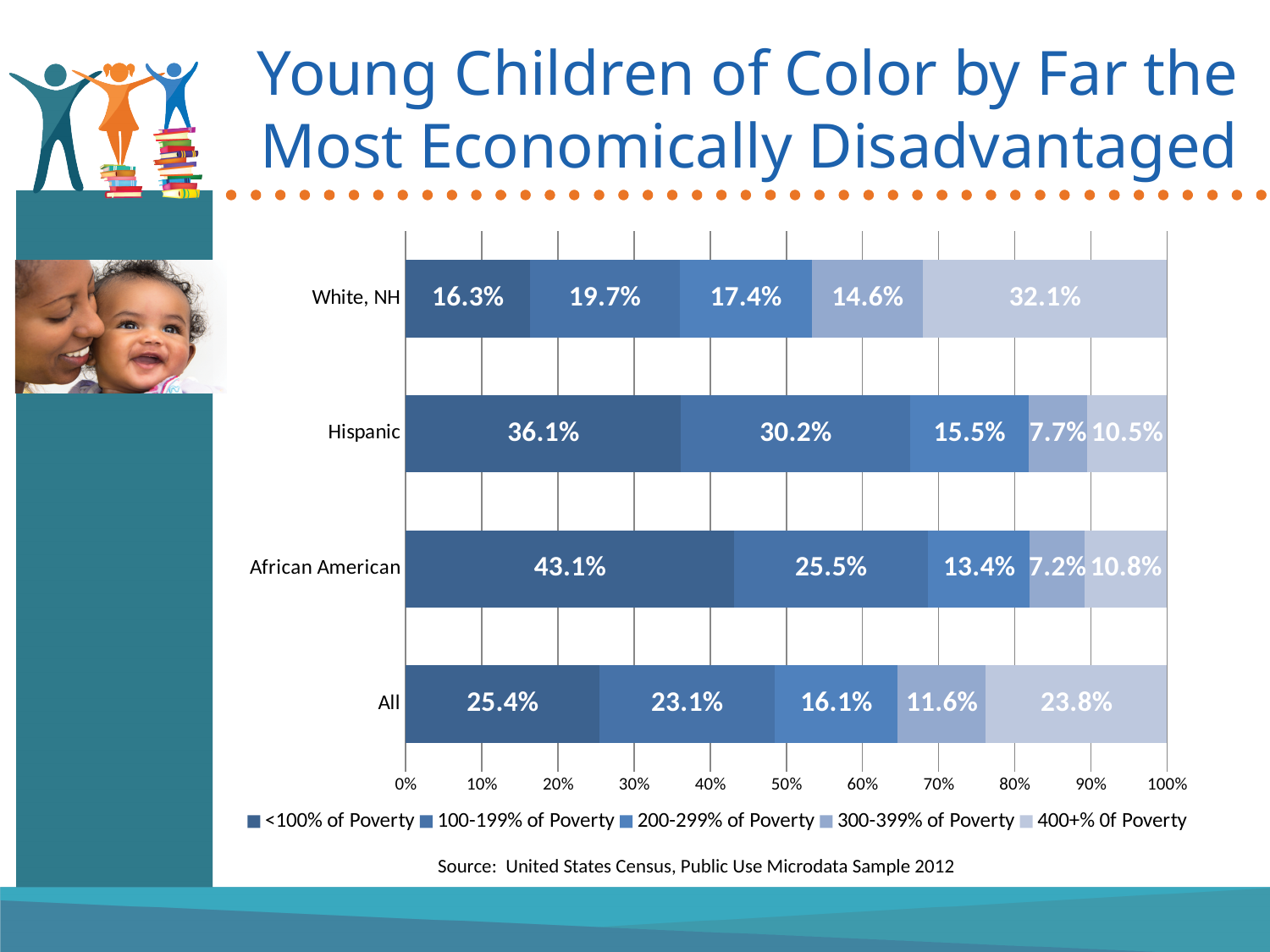
What percentage of White, NH young children are below 100% of poverty? 16.3% What kind of chart is shown on the slide? Stacked bar chart Which is larger: the 200-299% of Poverty value for Hispanic or for All? All How many series does the legend list? 5 How many categories (bars) are shown on the chart? 4 What is the 300-399% of Poverty value for the 'All' category? 11.6% Which category has the highest value in the 400+% of Poverty series? White, NH How many percentage points higher is the <100% of Poverty value for African American children than for White, NH children? 26.8 percentage points Which category has the highest value in the <100% of Poverty series? African American Which category has the lowest value in the <100% of Poverty series? White, NH What is the value for Hispanic children in the 100-199% of Poverty series? 30.2% What share of African American young children are at 400+% of poverty? 10.8%